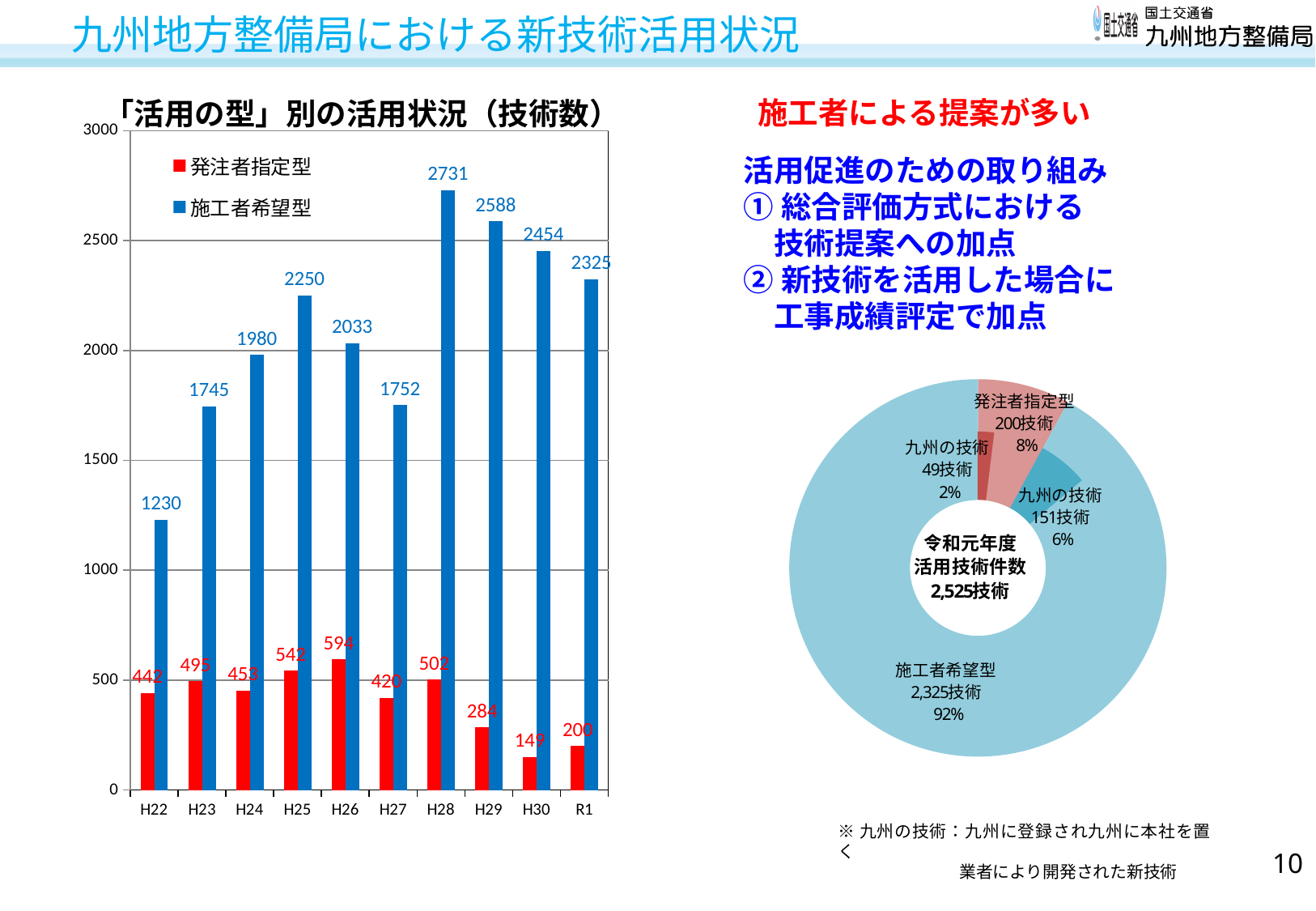
In the bar chart titled 「活用の型」別の活用状況（技術数）, which year has the lowest 発注者指定型 value? H30 In the bar chart titled 「活用の型」別の活用状況（技術数）, what is the value of 施工者希望型 for H28? 2731 In the bar chart titled 「活用の型」別の活用状況（技術数）, how many years are shown on the x axis? 10 In the bar chart titled 「活用の型」別の活用状況（技術数）, how many series does the legend list? 2 In the bar chart titled 「活用の型」別の活用状況（技術数）, which is larger: the 施工者希望型 value for H25 or for H26? H25 In the bar chart titled 「活用の型」別の活用状況（技術数）, which year has the highest 施工者希望型 value? H28 In the bar chart titled 「活用の型」別の活用状況（技術数）, what is the difference between the 施工者希望型 values for H28 and H22? 1501 What kind of chart is the chart on the left of the slide? Bar chart In the bar chart titled 「活用の型」別の活用状況（技術数）, what is the value of 発注者指定型 for H30? 149 In the doughnut chart on the right, what share does 施工者希望型 represent? 92% In the doughnut chart on the right, what is the total number of technologies shown in the centre for 令和元年度? 2,525技術 In the bar chart titled 「活用の型」別の活用状況（技術数）, what is the value of 発注者指定型 for H26? 594